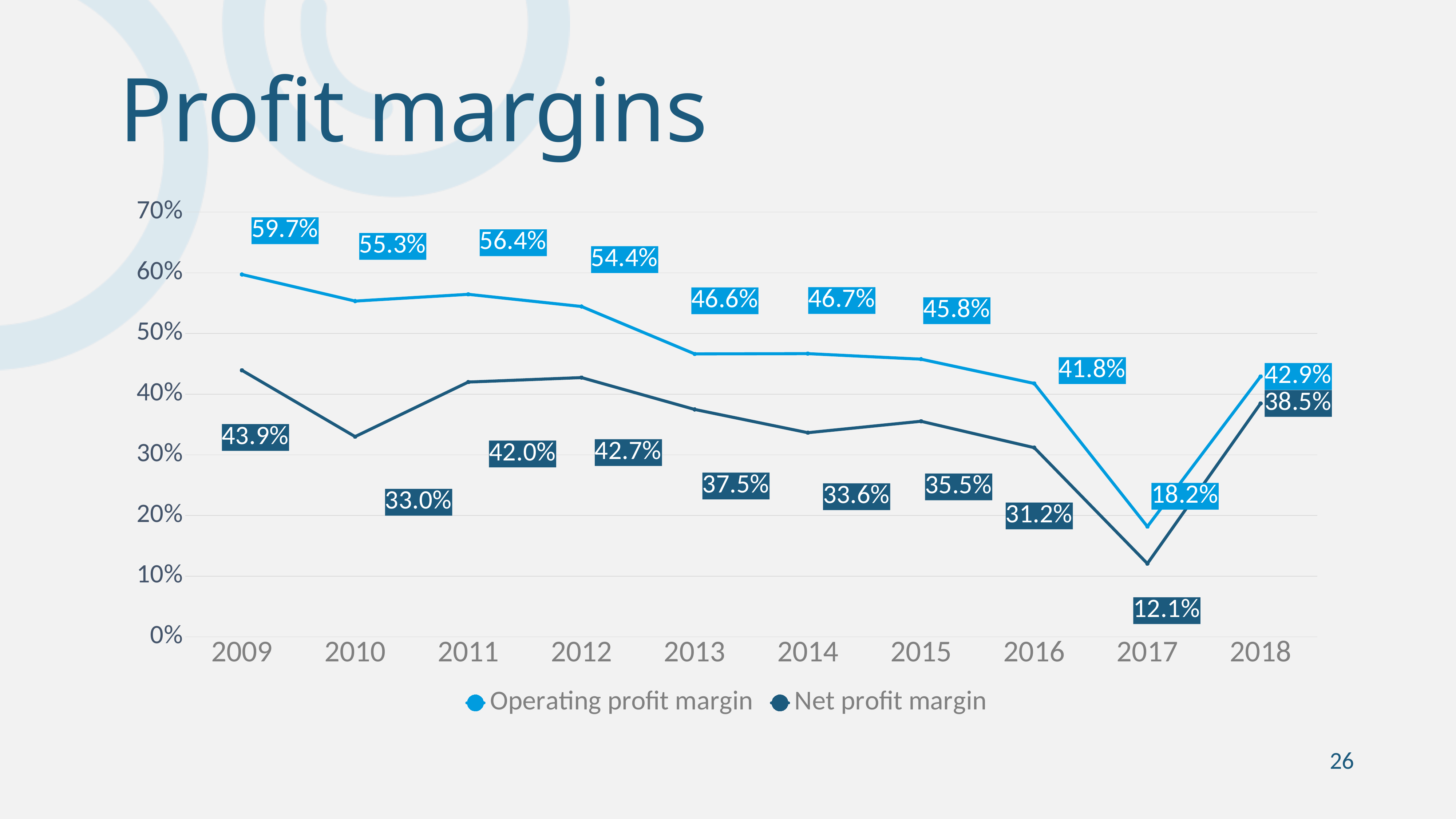
In which year is the net profit margin highest? 2009 How many years are shown on the x axis? 10 What is the operating profit margin in 2009? 59.7% Which is larger in 2013: the operating profit margin or the net profit margin? Operating profit margin What is the net profit margin in 2012? 42.7% In which year is the operating profit margin lowest? 2017 What is the difference between the operating profit margin and the net profit margin in 2018? 4.4% What is the operating profit margin in 2016? 41.8% How many series does the legend list? 2 What kind of chart is shown on the slide? Line chart What is the net profit margin in 2017? 12.1% What is the title of the chart? Profit margins